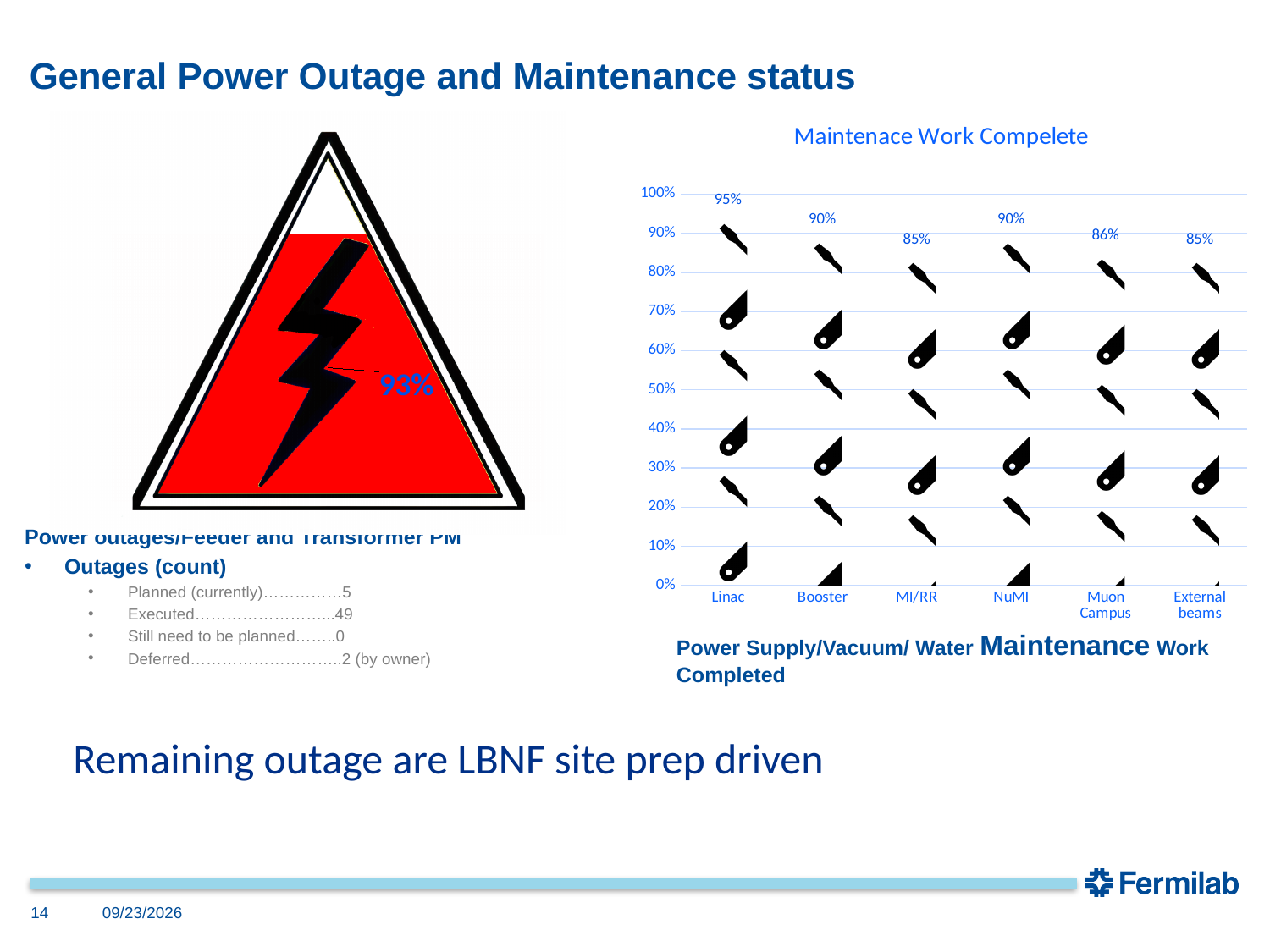
How many categories are shown on the x axis of the Maintenace Work Compelete chart? 6 In the Maintenace Work Compelete chart, which is larger, the value for Linac or the value for Muon Campus? Linac In the Maintenace Work Compelete chart, what is the difference between the Linac value and the Booster value? 5% In the Maintenace Work Compelete chart, what is the difference between the NuMI value and the Muon Campus value? 4% In the Maintenace Work Compelete chart, is the value for Muon Campus greater or less than 80%? greater In the Maintenace Work Compelete chart, which category has the highest value? Linac What kind of chart is the Maintenace Work Compelete chart? bar chart In the Maintenace Work Compelete chart, what is the value for Linac? 95% In the Maintenace Work Compelete chart, what is the value for External beams? 85% In the Maintenace Work Compelete chart, what is the value for MI/RR? 85% In the Maintenace Work Compelete chart, what is the value for Booster? 90% In the Maintenace Work Compelete chart, what is the value for Muon Campus? 86%